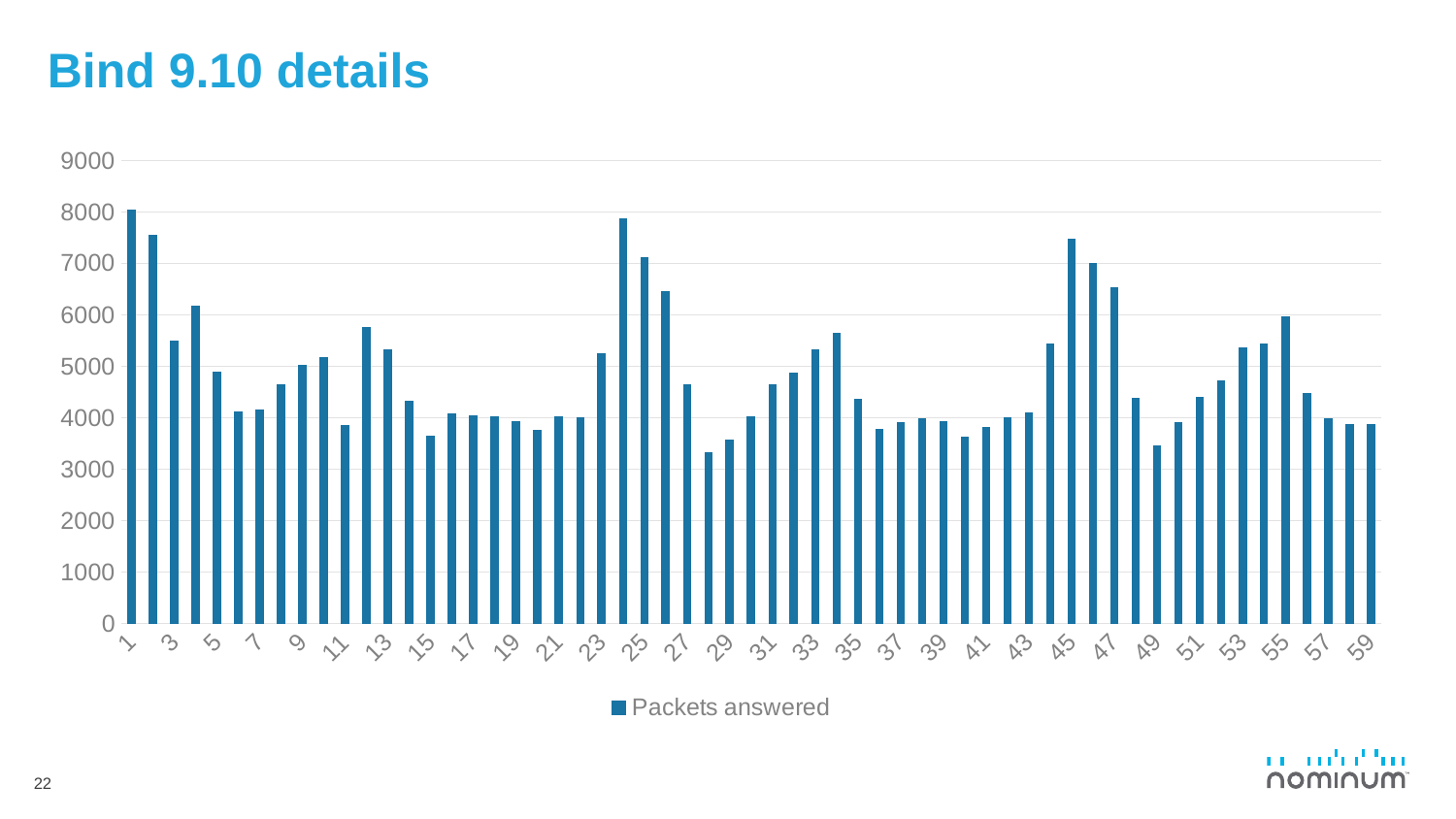
Is the value for category 45 greater or less than 7000? greater Do the values rise or fall from category 45 to category 49? fall What is the title of the slide containing the chart? Bind 9.10 details How many series does the legend list? 1 What kind of chart is shown on the slide? bar chart Is the value for category 15 greater or less than 4000? less Is the value for category 12 greater or less than 5000? greater Which has the larger value, category 24 or category 25? 24 Which has the larger value, category 1 or category 28? 1 What is the name of the series shown in the legend? Packets answered